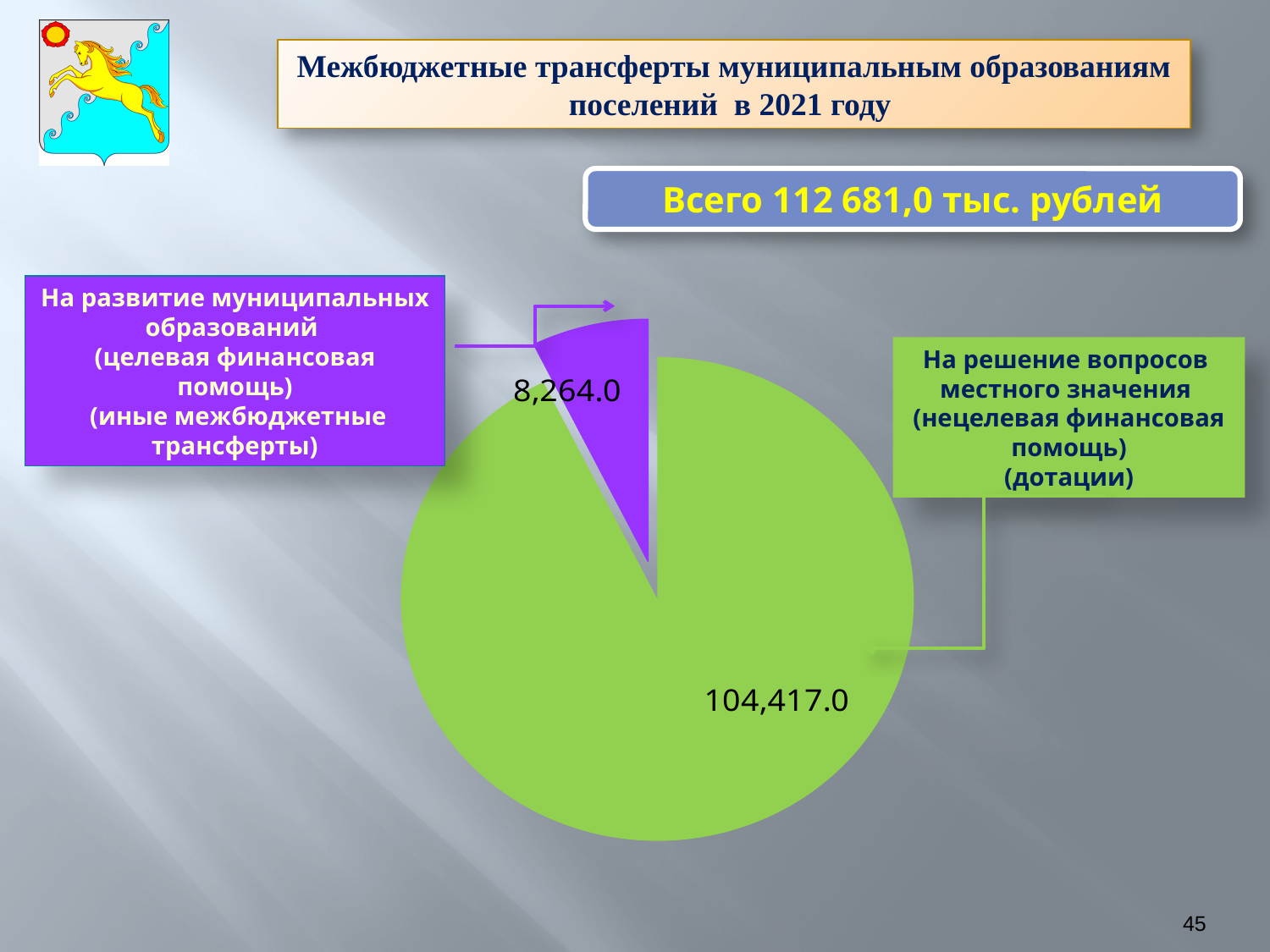
What is the value of the slice for «На решение вопросов местного значения (нецелевая финансовая помощь) (дотации)»? 104,417.0 What colour is the slice for дотации? green Which is larger: the slice for дотации or the slice for иные межбюджетные трансферты? дотации What share of the total do иные межбюджетные трансферты (8,264.0) represent? 7.3% What is the difference between the value for дотации and the value for иные межбюджетные трансферты? 96,153.0 What is the title of the slide? Межбюджетные трансферты муниципальным образованиям поселений в 2021 году Which category has the largest slice in the pie chart? На решение вопросов местного значения (нецелевая финансовая помощь) (дотации) What total amount of interbudget transfers is stated on the slide? 112 681,0 тыс. рублей What type of chart is shown on the slide? pie chart Which category has the smallest slice in the pie chart? На развитие муниципальных образований (целевая финансовая помощь) (иные межбюджетные трансферты) How many slices does the pie chart have? 2 What is the value of the slice for «На развитие муниципальных образований (целевая финансовая помощь) (иные межбюджетные трансферты)»? 8,264.0